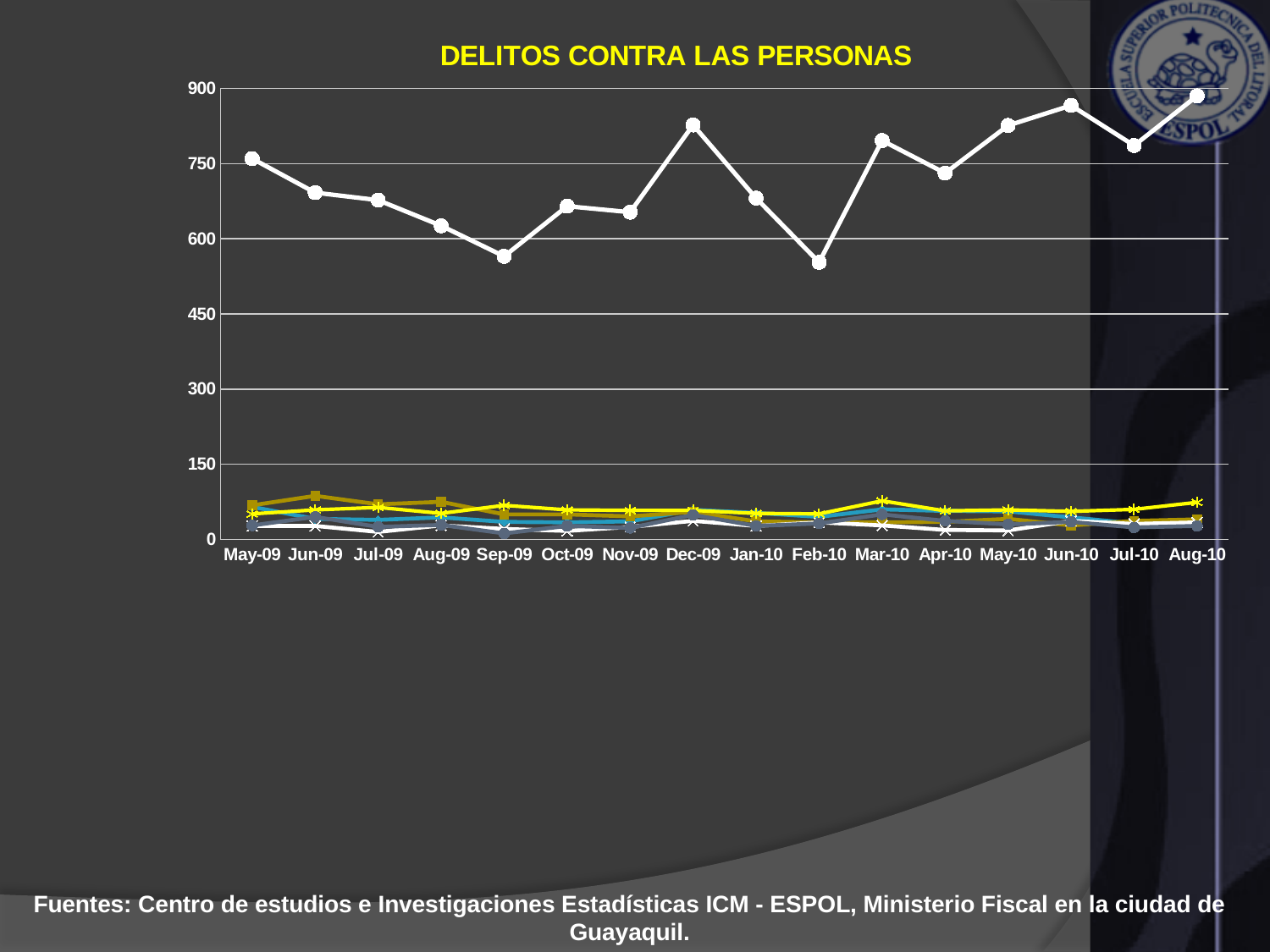
For the top white line with circle markers, is the value for Jun-09 greater or less than 750? less For the top white line with circle markers, is the value for Aug-10 greater or less than 750? greater For the top white line with circle markers, do the values rise or fall from May-09 to Sep-09? fall What is the highest value shown on the y axis of the chart? 900 For the top white line with circle markers, is the value for Feb-10 greater or less than 600? less What type of chart is shown on the slide? line chart What is the title of the chart? DELITOS CONTRA LAS PERSONAS For the top white line with circle markers, which month has the highest value? Aug-10 How many months are shown along the x axis of the chart? 16 For the top white line with circle markers, which is larger, the value for Dec-09 or the value for Jan-10? Dec-09